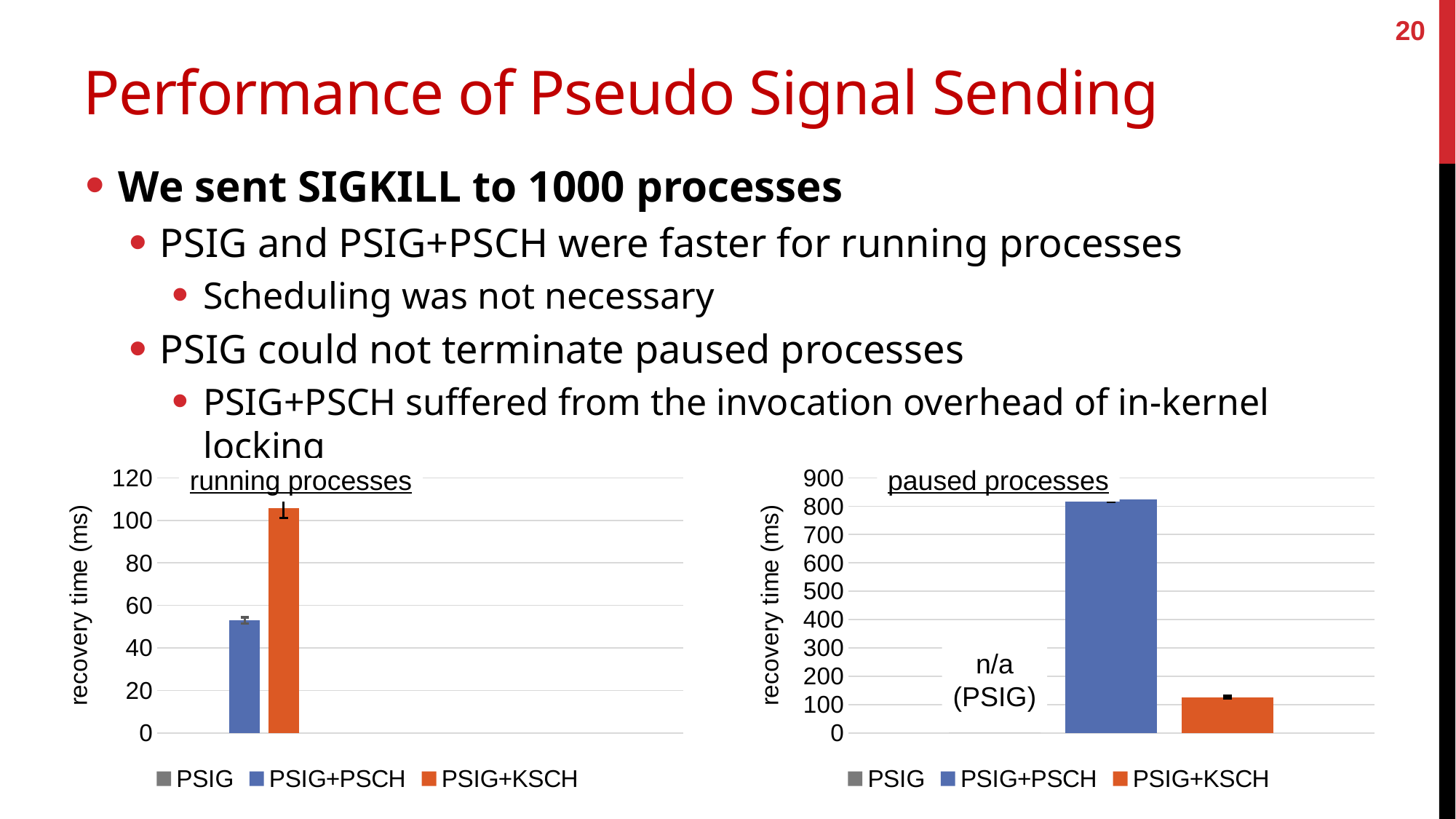
In the 'paused processes' chart, is the recovery time for PSIG+PSCH greater or less than 800? greater In the 'running processes' chart, what is the label of the y axis? recovery time (ms) In the 'running processes' chart, what kind of chart is shown? bar chart In the 'running processes' chart, how many series does the legend list? 3 In the 'running processes' chart, is the recovery time for PSIG+PSCH greater or less than 60? less In the 'paused processes' chart, which series has the lower recovery time, PSIG+PSCH or PSIG+KSCH? PSIG+KSCH In the 'paused processes' chart, is the recovery time for PSIG+KSCH greater or less than 200? less In the 'paused processes' chart, how many series does the legend list? 3 In the 'paused processes' chart, which series has the highest recovery time? PSIG+PSCH In the 'paused processes' chart, which series is marked as n/a? PSIG In the 'running processes' chart, which series has the higher recovery time, PSIG+PSCH or PSIG+KSCH? PSIG+KSCH